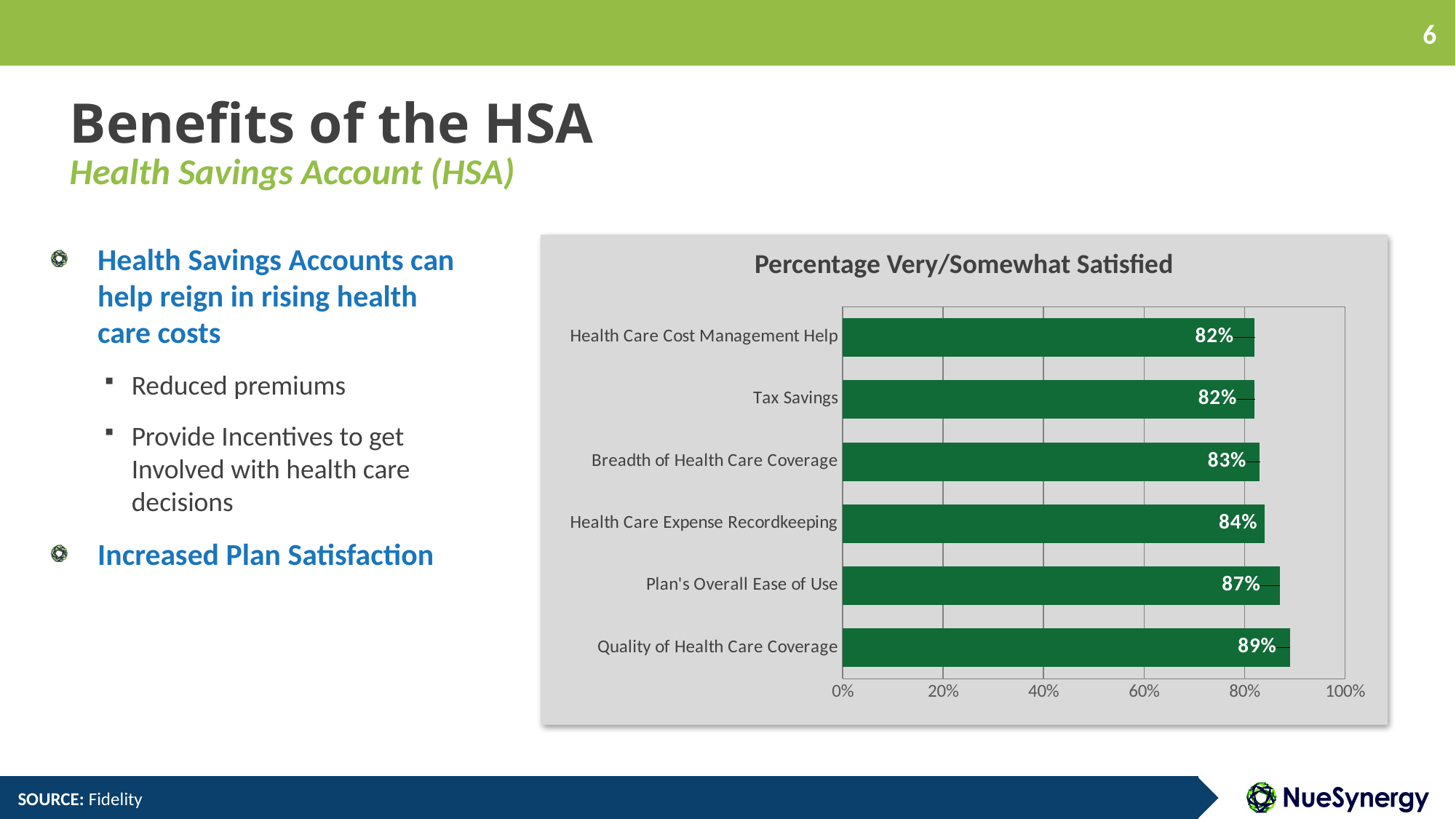
What kind of chart is shown on the slide? bar chart What is the title of the chart? Percentage Very/Somewhat Satisfied What is the value for Health Care Expense Recordkeeping? 84% What is the value for Quality of Health Care Coverage? 89% What is the difference between Plan's Overall Ease of Use and Breadth of Health Care Coverage? 4% What is the difference between Quality of Health Care Coverage and Tax Savings? 7% What is the value for Tax Savings? 82% Which category has the highest percentage satisfied? Quality of Health Care Coverage How many categories are shown in the chart? 6 What is the value for Plan's Overall Ease of Use? 87% Which is larger, Health Care Expense Recordkeeping or Breadth of Health Care Coverage? Health Care Expense Recordkeeping Is the value for Quality of Health Care Coverage greater or less than 80%? greater